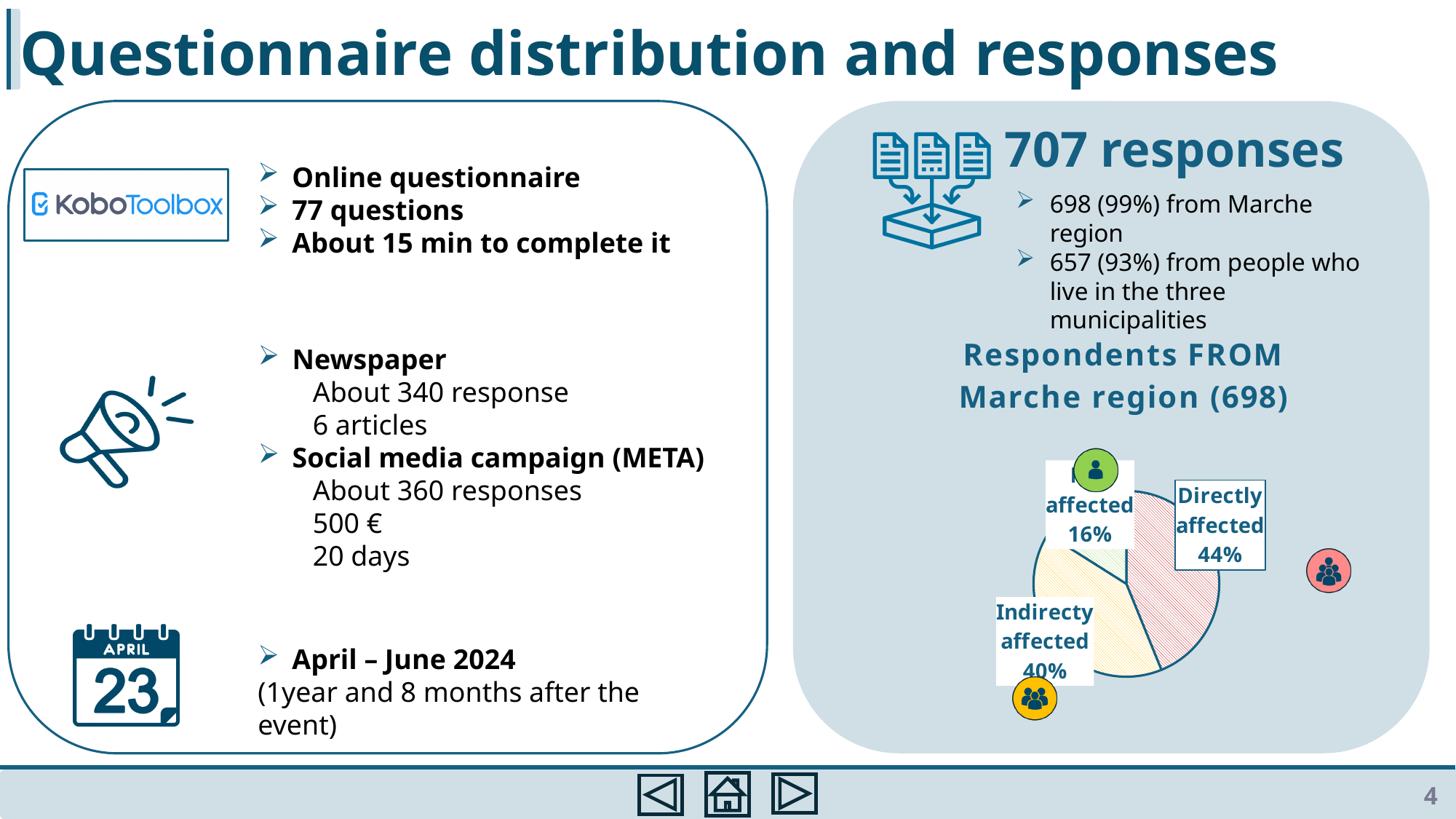
What is the difference in percentage points between the "Directly affected" and "Indirecty affected" slices? 4 What is the combined percentage of the "Directly affected" and "Indirecty affected" slices? 84% How many slices does the pie chart have? 3 What is the smallest percentage shown on the pie chart? 16% What number of respondents is given in the heading above the pie chart? 698 What colour is the "Directly affected" slice of the pie chart? red In the pie chart, what percentage of respondents are labelled "Indirecty affected"? 40% Which slice is larger in the pie chart: "Directly affected" or "Indirecty affected"? Directly affected What type of chart is shown under the heading "Respondents FROM Marche region (698)"? pie chart In the pie chart, what percentage of respondents are labelled "Directly affected"? 44% Which category has the largest share in the pie chart? Directly affected